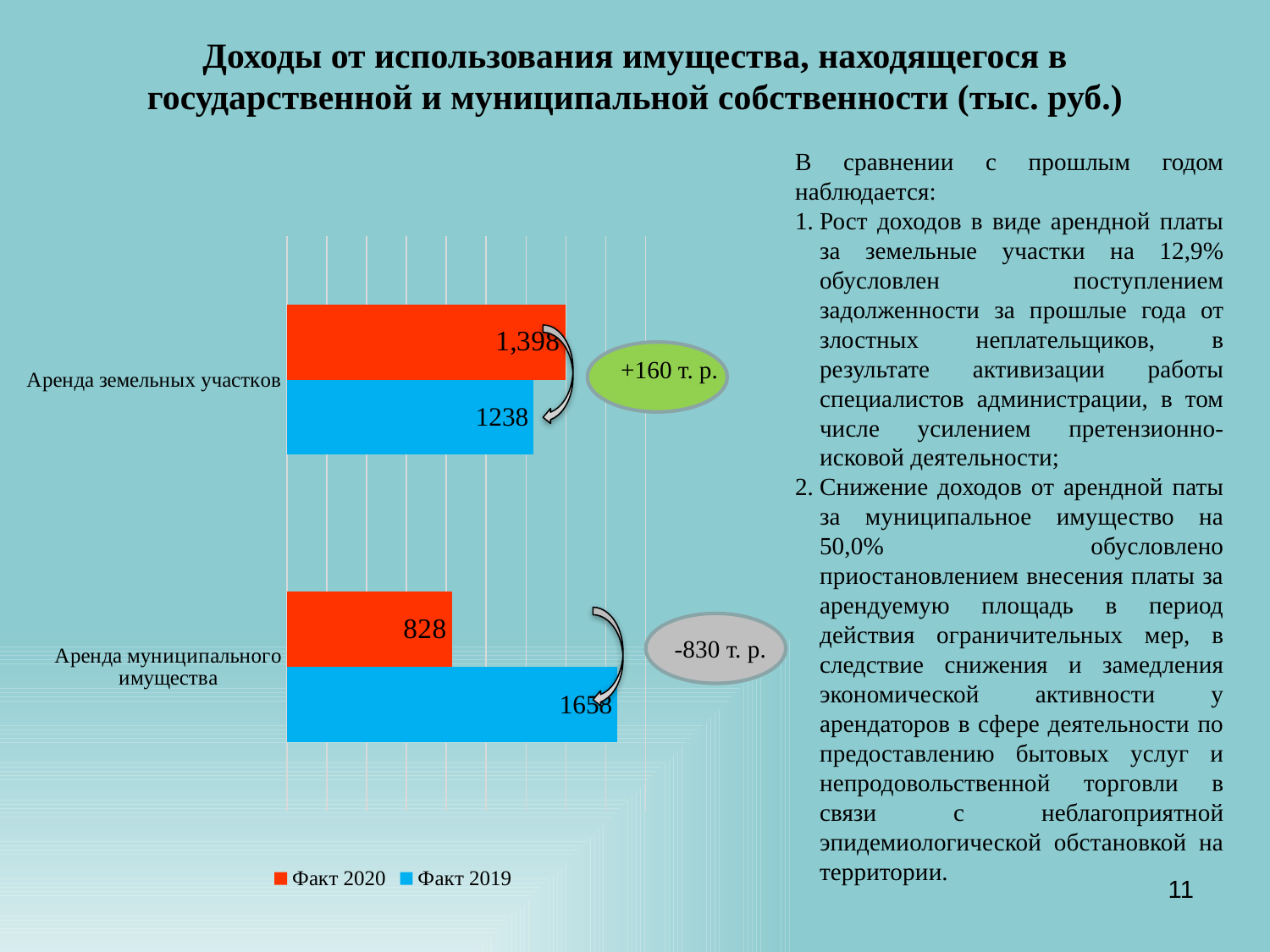
What kind of chart is shown on the slide? Bar chart What is the difference between Факт 2019 and Факт 2020 for Аренда муниципального имущества? 830 What is the value of Факт 2020 for Аренда земельных участков? 1,398 How many series does the legend list? 2 Which colour represents the Факт 2019 series in the chart? Blue What is the value of Факт 2019 for Аренда муниципального имущества? 1658 Which category has the highest Факт 2019 value? Аренда муниципального имущества What is the value of Факт 2019 for Аренда земельных участков? 1238 How many categories are shown in the chart? 2 What is the value of Факт 2020 for Аренда муниципального имущества? 828 Which category has the lowest Факт 2020 value? Аренда муниципального имущества Which is larger for Аренда земельных участков: Факт 2020 or Факт 2019? Факт 2020